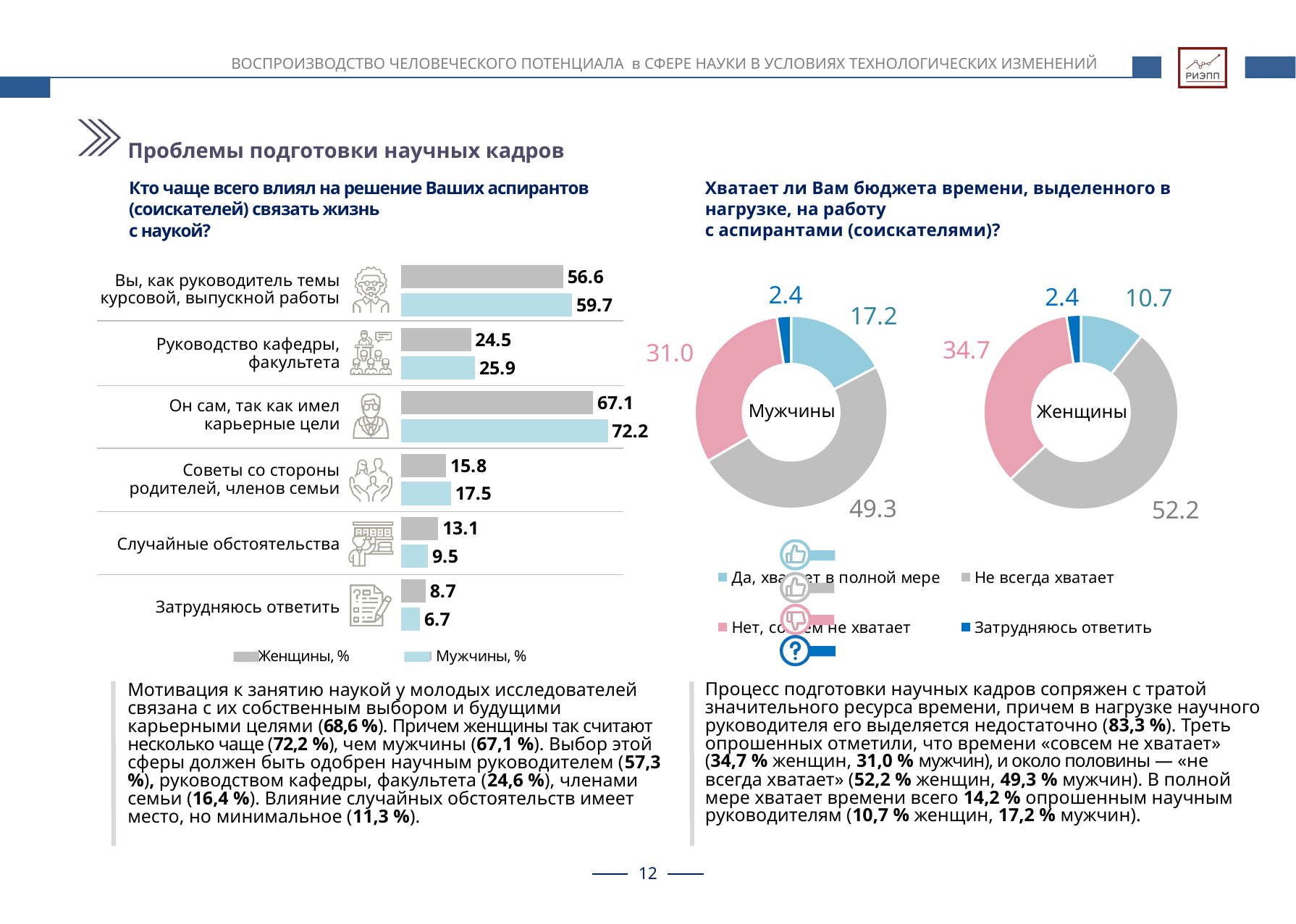
What kind of chart is the left chart titled «Кто чаще всего влиял на решение Ваших аспирантов (соискателей) связать жизнь с наукой?»? Bar chart In the «Женщины» donut chart on the right, which category has the smallest value? Затрудняюсь ответить In the left bar chart, how many series does the legend list? 2 In the left bar chart, which category has the highest value? Он сам, так как имел карьерные цели In the left bar chart, what is the value for «Случайные обстоятельства» in the «Мужчины, %» series? 9.5 In the «Мужчины» donut chart on the right, what is the value for «Не всегда хватает»? 49.3 In the left bar chart, how many categories are shown? 6 In the left bar chart, for «Случайные обстоятельства», which series has the larger value? Женщины, % In the left bar chart, what is the difference between the two values for «Он сам, так как имел карьерные цели»? 5.1 In the «Мужчины» donut chart on the right, how many slices are there? 4 Comparing the two donut charts on the right, which group has the larger value for «Да, хватает в полной мере»? Мужчины In the «Женщины» donut chart on the right, what is the value for «Нет, совсем не хватает»? 34.7